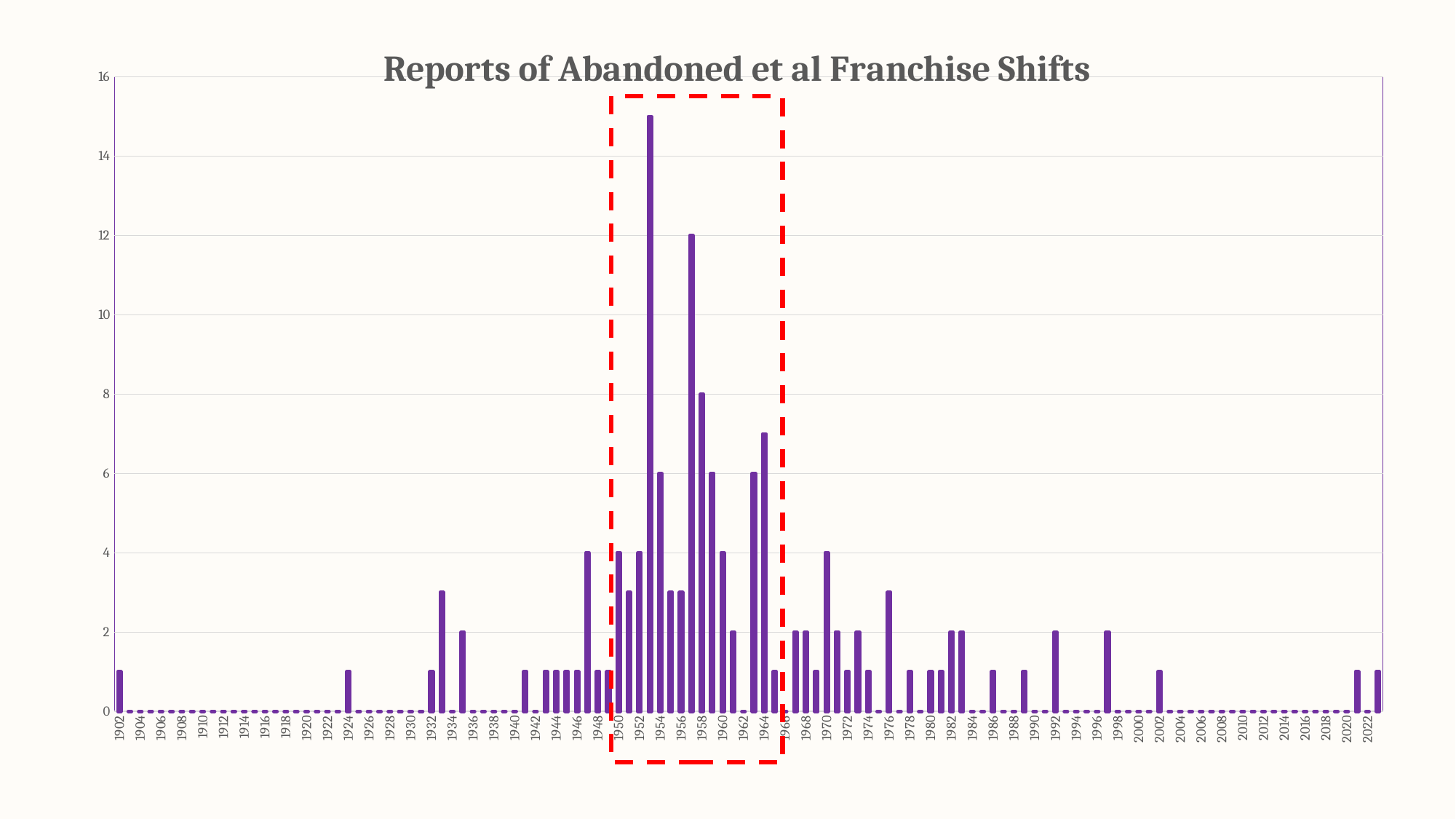
What is the value for 1970? 4 Is the value for 1976 greater or less than 4? less Is the value for 1964 greater or less than 6? greater Is the tallest bar on the chart greater or less than 14? greater What kind of chart is shown on the slide? Bar chart What is the difference between the values for 1958 and 1954? 2 What is the value for 1960? 4 Which year has the larger value, 1958 or 1954? 1958 What is the value for 1992? 2 What is the title of the chart? Reports of Abandoned et al Franchise Shifts What is the value for 1954? 6 What is the value for 1958? 8